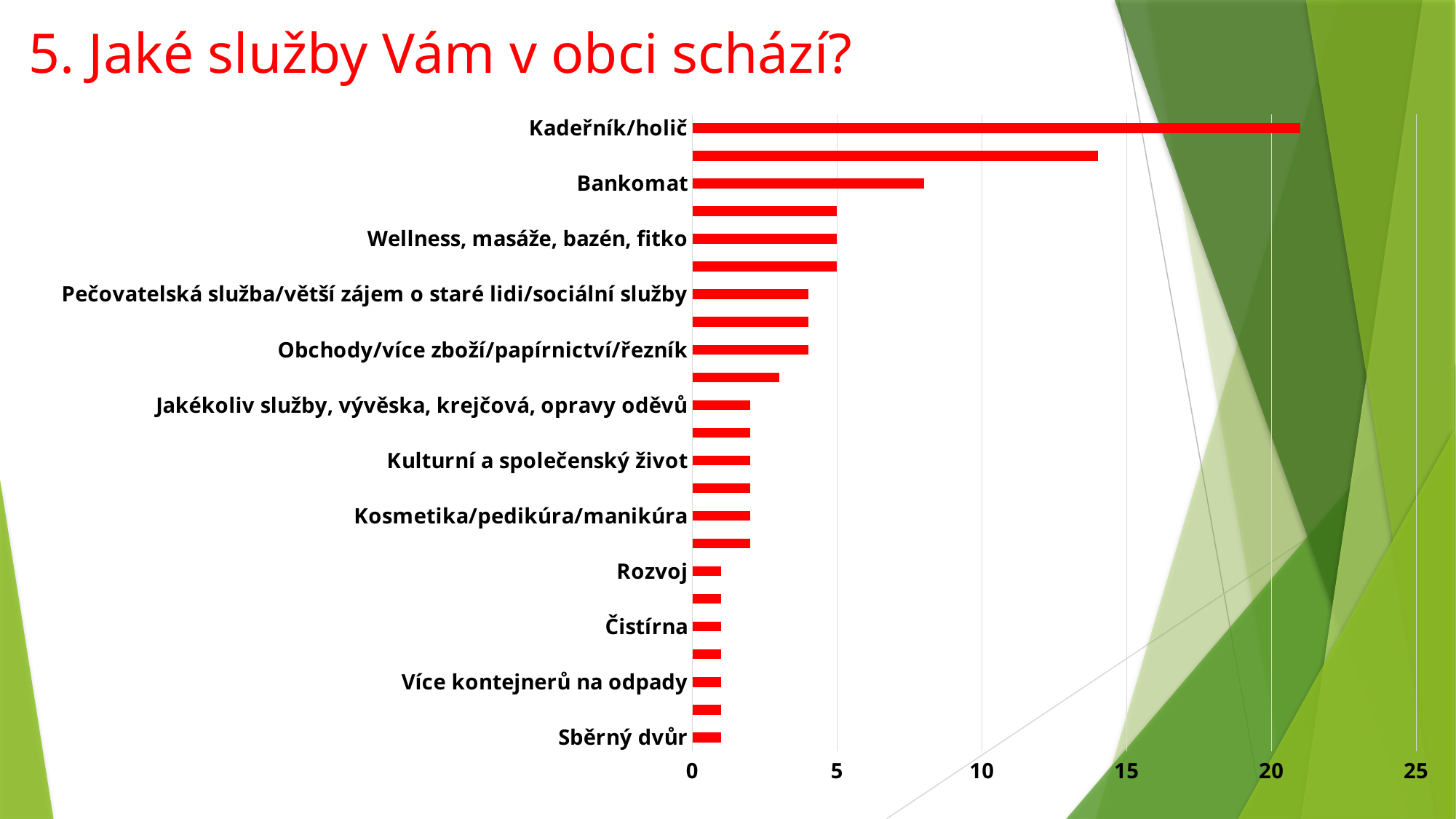
What is the value for Wellness, masáže, bazén, fitko? 5 Is the value for Pečovatelská služba/větší zájem o staré lidi/sociální služby greater or less than 5? less Is the value for Bankomat greater or less than 10? less Which is larger, the value for Bankomat or the value for Kulturní a společenský život? Bankomat Which is larger, the value for Kadeřník/holič or the value for Bankomat? Kadeřník/holič Is the value for Kadeřník/holič greater or less than 20? greater What kind of chart is shown on the slide? bar chart What is the title of the slide containing the chart? 5. Jaké služby Vám v obci schází? What colour are the bars in the chart? red Which category has the longest bar in the chart? Kadeřník/holič